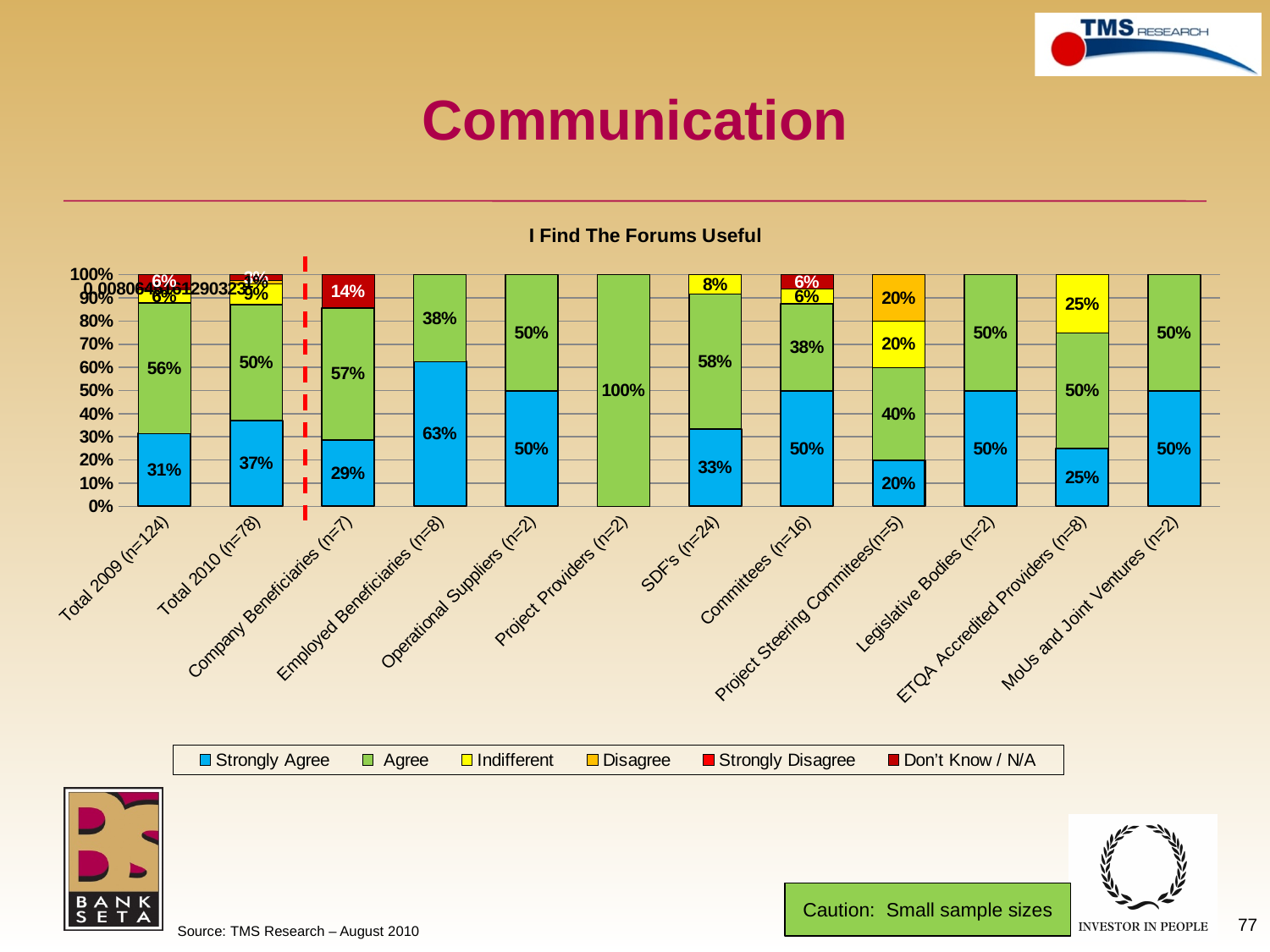
What is the Don't Know / N/A value for Company Beneficiaries (n=7)? 14% What kind of chart is shown on the slide? Stacked bar chart For Total 2009 (n=124), how many percentage points higher is Agree than Strongly Agree? 25 percentage points Which category has the highest Strongly Agree percentage? Employed Beneficiaries (n=8) How many categories are shown on the x axis of the chart? 12 What is the Agree value for SDF's (n=24)? 58% Which has the larger Strongly Agree percentage, Total 2009 (n=124) or Total 2010 (n=78)? Total 2010 (n=78) What is the Agree value for Project Providers (n=2)? 100% What percentage of Employed Beneficiaries (n=8) Strongly Agree that they find the forums useful? 63% What is the Indifferent value for ETQA Accredited Providers (n=8)? 25% How many series does the legend list? 6 What is the Disagree value for Project Steering Committees (n=5)? 20%